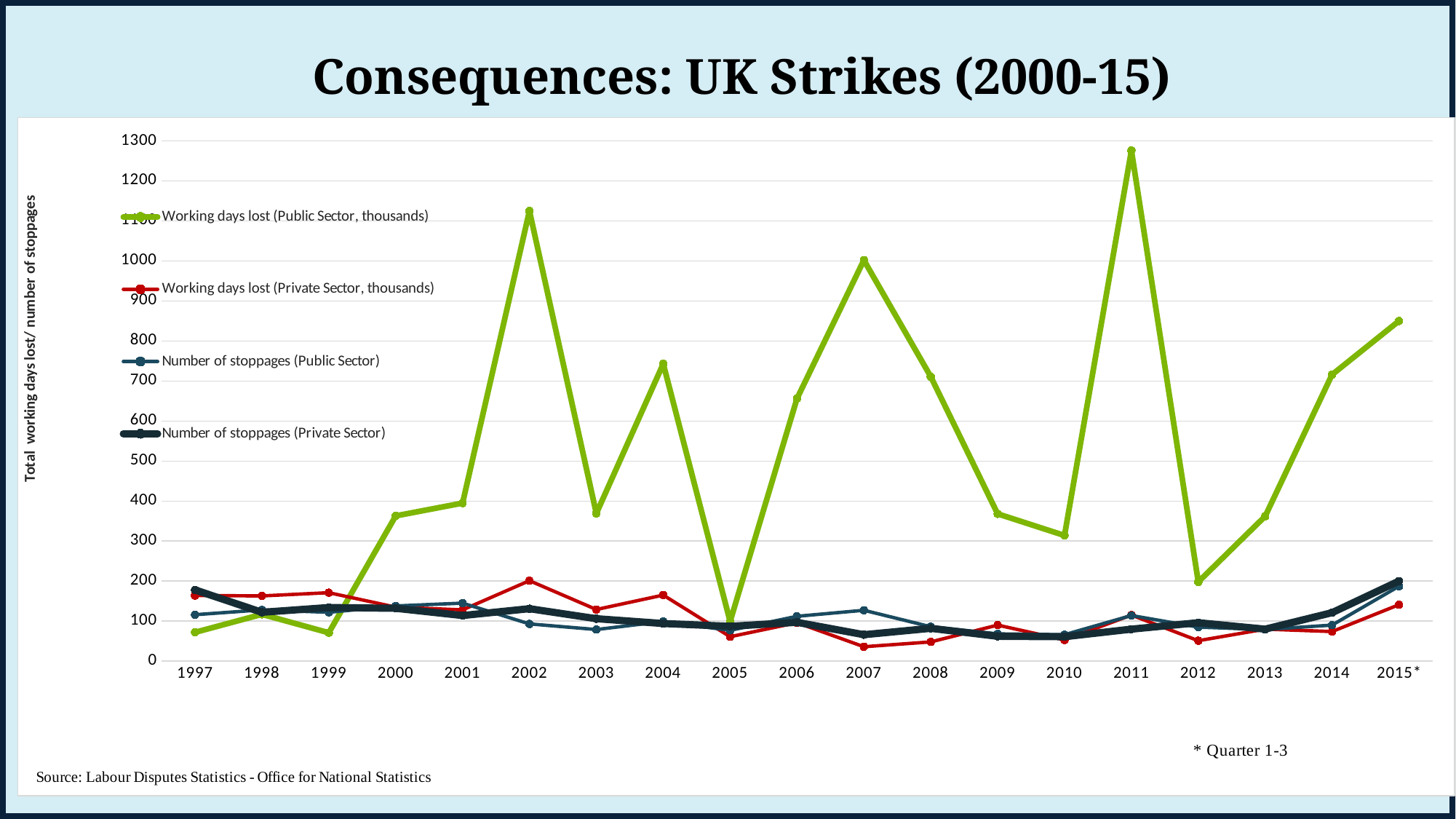
Does the value for Working days lost (Public Sector, thousands) rise or fall from 2012 to 2015*? rise How many series does the legend list? 4 How many years are plotted along the x axis? 19 Is the value for Working days lost (Public Sector, thousands) in 2012 greater or less than 300? less What kind of chart is shown on the slide? line chart Which is larger for Working days lost (Public Sector, thousands): the value in 2002 or the value in 2004? 2002 In which year is the value for Working days lost (Private Sector, thousands) highest? 2002 In which year is the value for Working days lost (Private Sector, thousands) lowest? 2007 Is the value for Working days lost (Public Sector, thousands) in 2011 greater or less than 1200? greater Is the value for Working days lost (Public Sector, thousands) in 2005 greater or less than 200? less What colour is the line for Working days lost (Public Sector, thousands)? green In which year is the value for Working days lost (Public Sector, thousands) highest? 2011